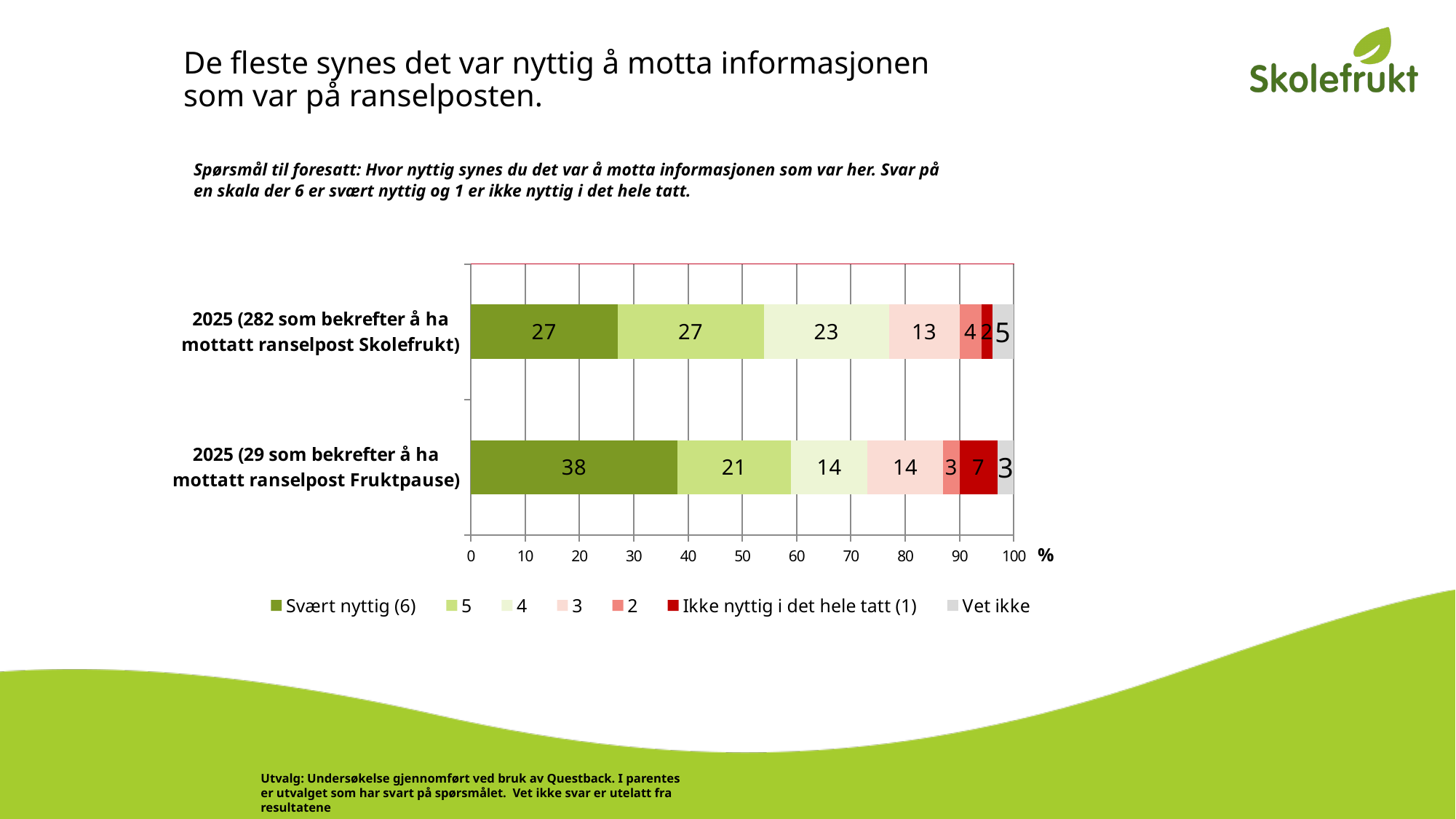
What is the value for 'Svært nyttig (6)' in the '2025 (29 som bekrefter å ha mottatt ranselpost Fruktpause)' bar? 38 Which category has the higher value for 'Svært nyttig (6)'? 2025 (29 som bekrefter å ha mottatt ranselpost Fruktpause) What is the value for 'Svært nyttig (6)' in the '2025 (282 som bekrefter å ha mottatt ranselpost Skolefrukt)' bar? 27 What unit is shown at the end of the x axis? % What is the value for 'Ikke nyttig i det hele tatt (1)' in the '2025 (29 som bekrefter å ha mottatt ranselpost Fruktpause)' bar? 7 What is the total of the '2025 (29 som bekrefter å ha mottatt ranselpost Fruktpause)' stacked bar? 100 How many series does the legend list? 7 What is the difference between the '4' values of the Skolefrukt bar (23) and the Fruktpause bar (14)? 9 How many categories (bars) are shown in the chart? 2 What is the value for 'Vet ikke' in the '2025 (282 som bekrefter å ha mottatt ranselpost Skolefrukt)' bar? 5 What is the difference between the 'Svært nyttig (6)' values of the Fruktpause bar and the Skolefrukt bar? 11 What kind of chart is shown on the slide? Stacked bar chart